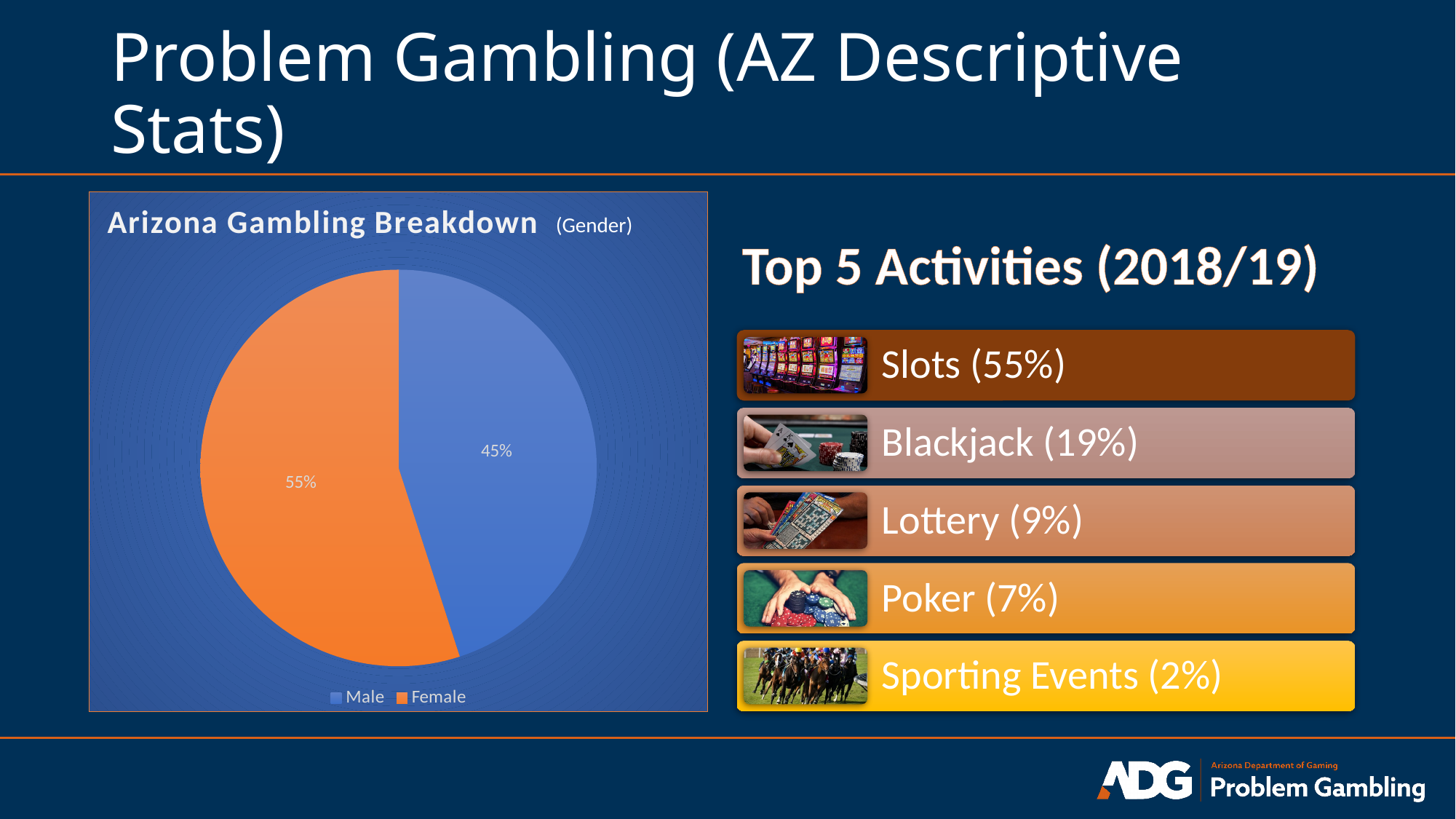
What kind of chart is shown on the slide? pie chart How many slices does the pie chart have? 2 What percentage of the pie chart is labelled for Female? 55% What is the title of the pie chart? Arizona Gambling Breakdown Which category has the smallest slice in the pie chart? Male How many entries does the pie chart's legend list? 2 Is the Male share in the pie chart greater or less than 50%? less By how many percentage points does the Female slice exceed the Male slice? 10% What colour represents Male in the pie chart? blue Which category has the largest slice in the pie chart? Female What percentage of the pie chart is labelled for Male? 45% Which slice is larger in the pie chart, Male or Female? Female